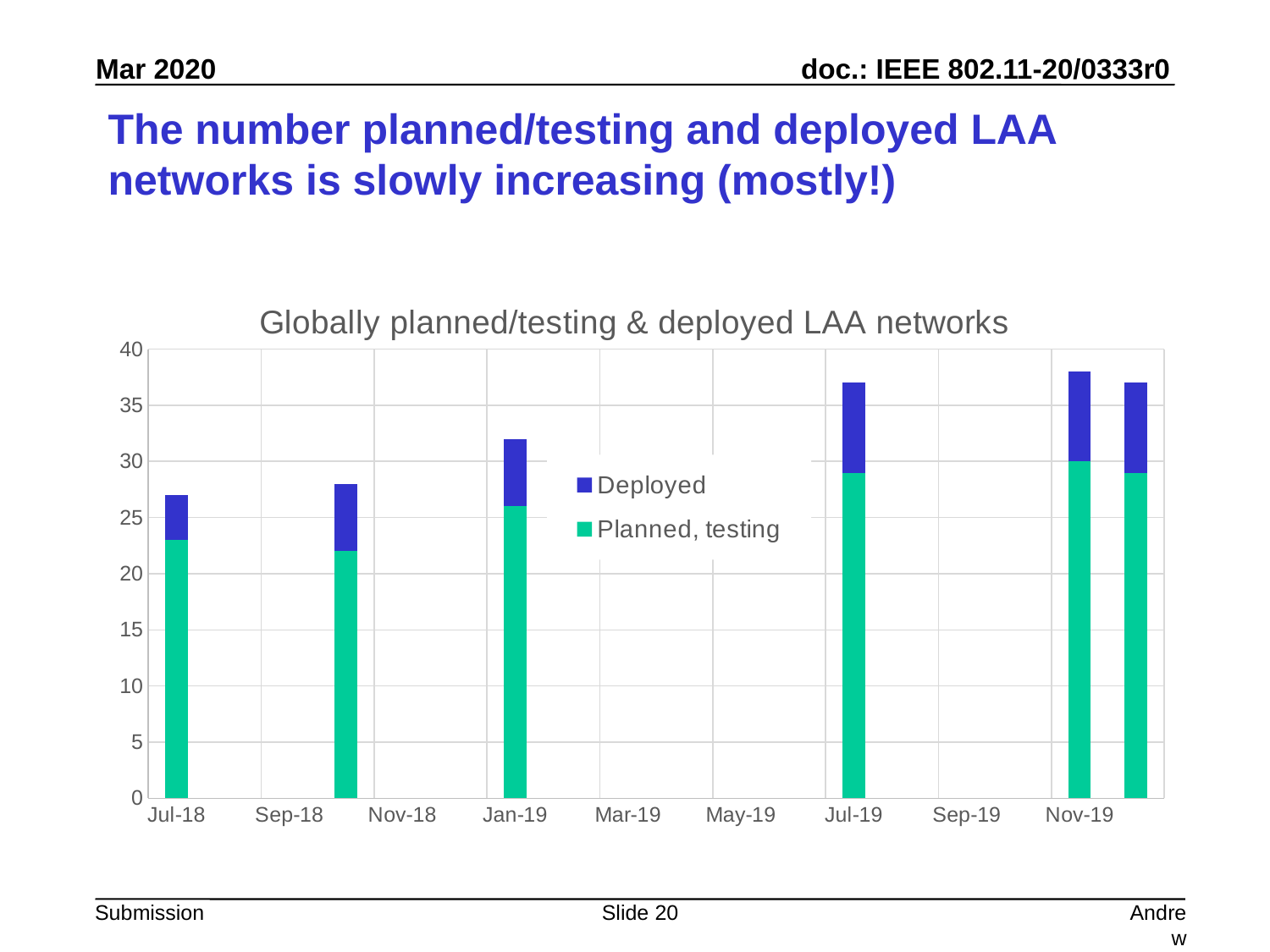
Is the total height of the Jul-19 bar greater or less than 35? greater Is the total height of the Jan-19 bar greater or less than 30? greater Is the 'Planned, testing' value for Nov-19 greater or less than 25? greater What kind of chart is shown on the slide? Stacked bar chart Which series is shown in green? Planned, testing Which bar is taller in total, Jul-18 or Jul-19? Jul-19 Do the total bar heights generally rise or fall from Jul-18 to Nov-19? rise What is the title of the chart? Globally planned/testing & deployed LAA networks How many series does the legend list? 2 How many bars are plotted in the chart? 6